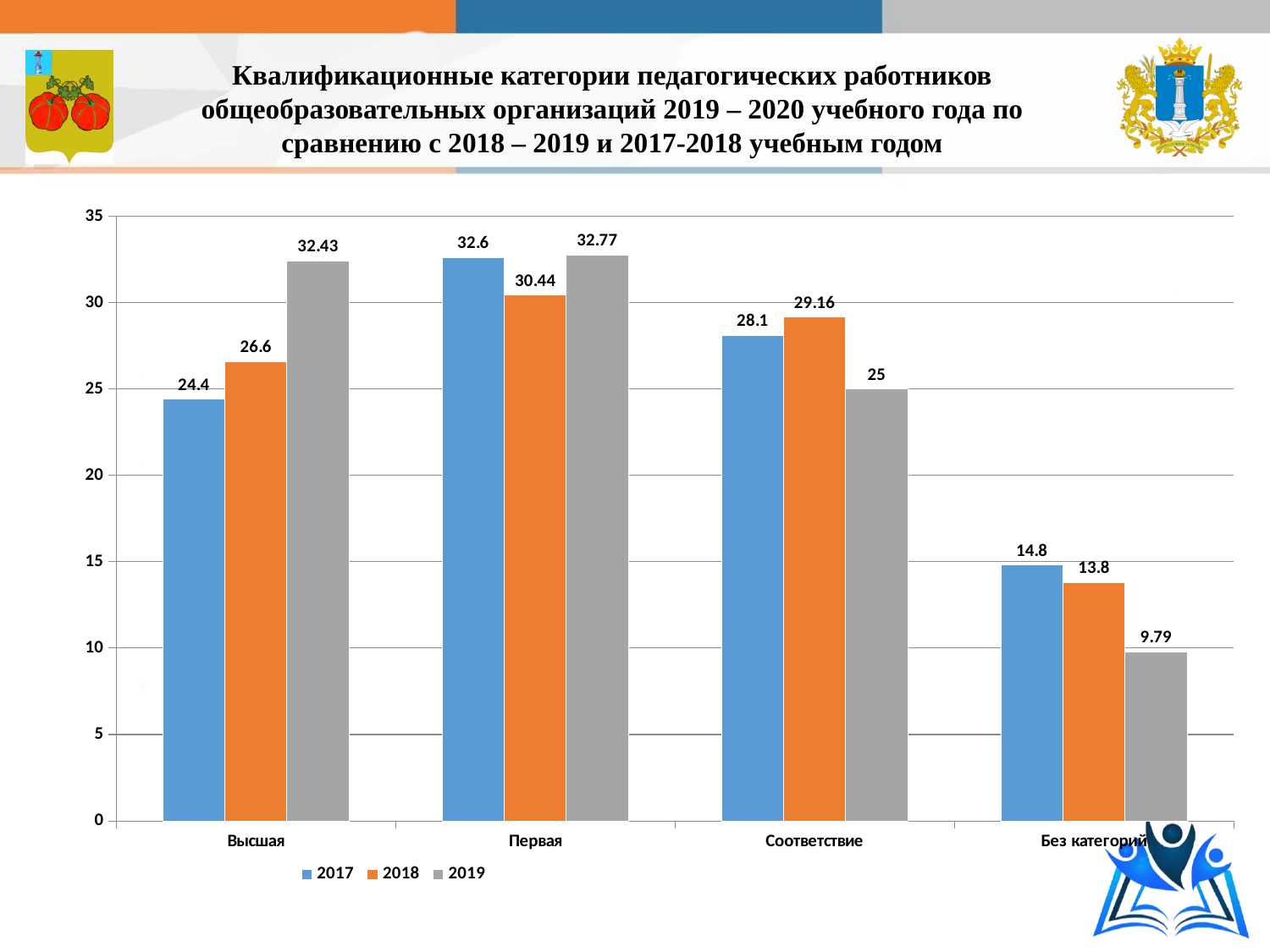
What is the value for Без категорий in the 2017 series? 14.8 How many categories are shown on the x axis? 4 Which is larger for Соответствие: the 2017 value or the 2019 value? 2017 What is the difference between the 2019 and 2017 values for Высшая? 8.03 What is the difference between the 2017 and 2019 values for Без категорий? 5.01 What is the value for Высшая in the 2019 series? 32.43 How many series does the legend list? 3 What kind of chart is shown on the slide? Bar chart What is the value for Соответствие in the 2018 series? 29.16 Which colour represents the 2018 series in the legend? Orange Which category has the highest value in the 2019 series? Первая Which category has the lowest value in the 2018 series? Без категорий